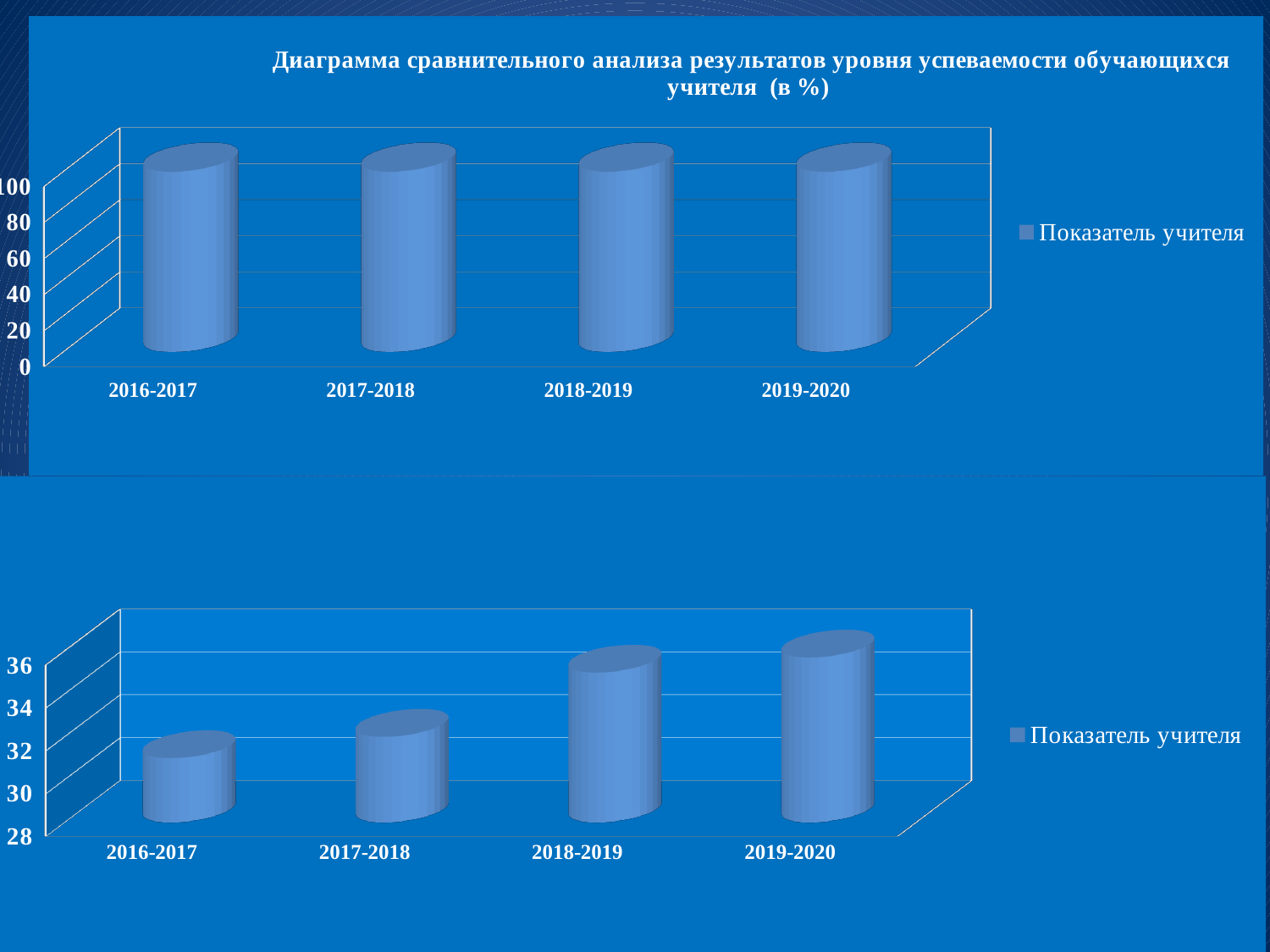
In the bottom chart, which category has the lowest value? 2016-2017 In the top chart, is the value for 2016-2017 greater or less than 80? greater In the bottom chart, do the values rise or fall from 2016-2017 to 2019-2020? rise In the bottom chart, is the value for 2017-2018 greater or less than 34? less In the top chart, do the values rise, fall or stay about the same from 2016-2017 to 2019-2020? stay about the same In the bottom chart, which is larger, the value for 2018-2019 or the value for 2017-2018? 2018-2019 How many categories are shown on the x axis of the top chart? 4 What kind of chart is the top chart on the slide? bar chart What is the title of the top chart? Диаграмма сравнительного анализа результатов уровня успеваемости обучающихся учителя (в %) In the bottom chart, is the value for 2019-2020 greater or less than 34? greater How many series does the legend of the top chart list? 1 In the bottom chart, which category has the highest value? 2019-2020